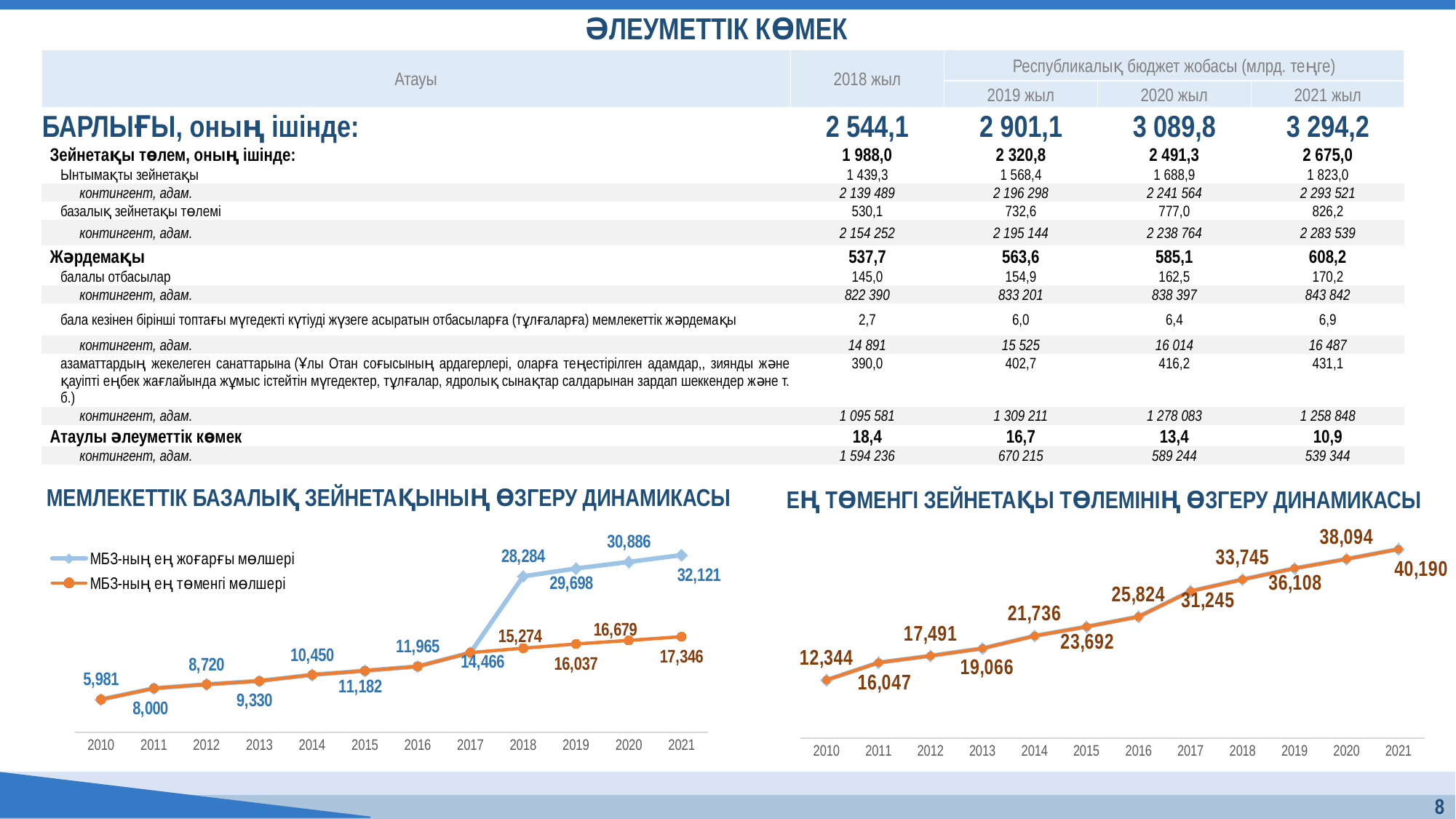
In the chart titled 'ЕҢ ТӨМЕНГІ ЗЕЙНЕТАҚЫ ТӨЛЕМІНІҢ ӨЗГЕРУ ДИНАМИКАСЫ', what is the value for 2017? 31,245 In the chart titled 'МЕМЛЕКЕТТІК БАЗАЛЫҚ ЗЕЙНЕТАҚЫНЫҢ ӨЗГЕРУ ДИНАМИКАСЫ', what is the difference between 'МБЗ-ның ең жоғарғы мөлшері' and 'МБЗ-ның ең төменгі мөлшері' in 2021? 14,775 In the chart titled 'ЕҢ ТӨМЕНГІ ЗЕЙНЕТАҚЫ ТӨЛЕМІНІҢ ӨЗГЕРУ ДИНАМИКАСЫ', what is the value for 2021? 40,190 In the chart titled 'ЕҢ ТӨМЕНГІ ЗЕЙНЕТАҚЫ ТӨЛЕМІНІҢ ӨЗГЕРУ ДИНАМИКАСЫ', how many years are plotted on the x axis? 12 In the chart titled 'МЕМЛЕКЕТТІК БАЗАЛЫҚ ЗЕЙНЕТАҚЫНЫҢ ӨЗГЕРУ ДИНАМИКАСЫ', what is the value of 'МБЗ-ның ең жоғарғы мөлшері' in 2021? 32,121 In the chart titled 'МЕМЛЕКЕТТІК БАЗАЛЫҚ ЗЕЙНЕТАҚЫНЫҢ ӨЗГЕРУ ДИНАМИКАСЫ', which series is higher in 2018, 'МБЗ-ның ең жоғарғы мөлшері' or 'МБЗ-ның ең төменгі мөлшері'? МБЗ-ның ең жоғарғы мөлшері In the chart titled 'ЕҢ ТӨМЕНГІ ЗЕЙНЕТАҚЫ ТӨЛЕМІНІҢ ӨЗГЕРУ ДИНАМИКАСЫ', what is the value for 2010? 12,344 In the chart titled 'МЕМЛЕКЕТТІК БАЗАЛЫҚ ЗЕЙНЕТАҚЫНЫҢ ӨЗГЕРУ ДИНАМИКАСЫ', what is the value of 'МБЗ-ның ең төменгі мөлшері' in 2019? 16,037 In the chart titled 'МЕМЛЕКЕТТІК БАЗАЛЫҚ ЗЕЙНЕТАҚЫНЫҢ ӨЗГЕРУ ДИНАМИКАСЫ', how many series does the legend list? 2 What kind of chart is the one titled 'МЕМЛЕКЕТТІК БАЗАЛЫҚ ЗЕЙНЕТАҚЫНЫҢ ӨЗГЕРУ ДИНАМИКАСЫ'? line chart In the chart titled 'ЕҢ ТӨМЕНГІ ЗЕЙНЕТАҚЫ ТӨЛЕМІНІҢ ӨЗГЕРУ ДИНАМИКАСЫ', do the values rise or fall from 2010 to 2021? rise In the chart titled 'ЕҢ ТӨМЕНГІ ЗЕЙНЕТАҚЫ ТӨЛЕМІНІҢ ӨЗГЕРУ ДИНАМИКАСЫ', what is the difference between the 2021 value and the 2010 value? 27,846